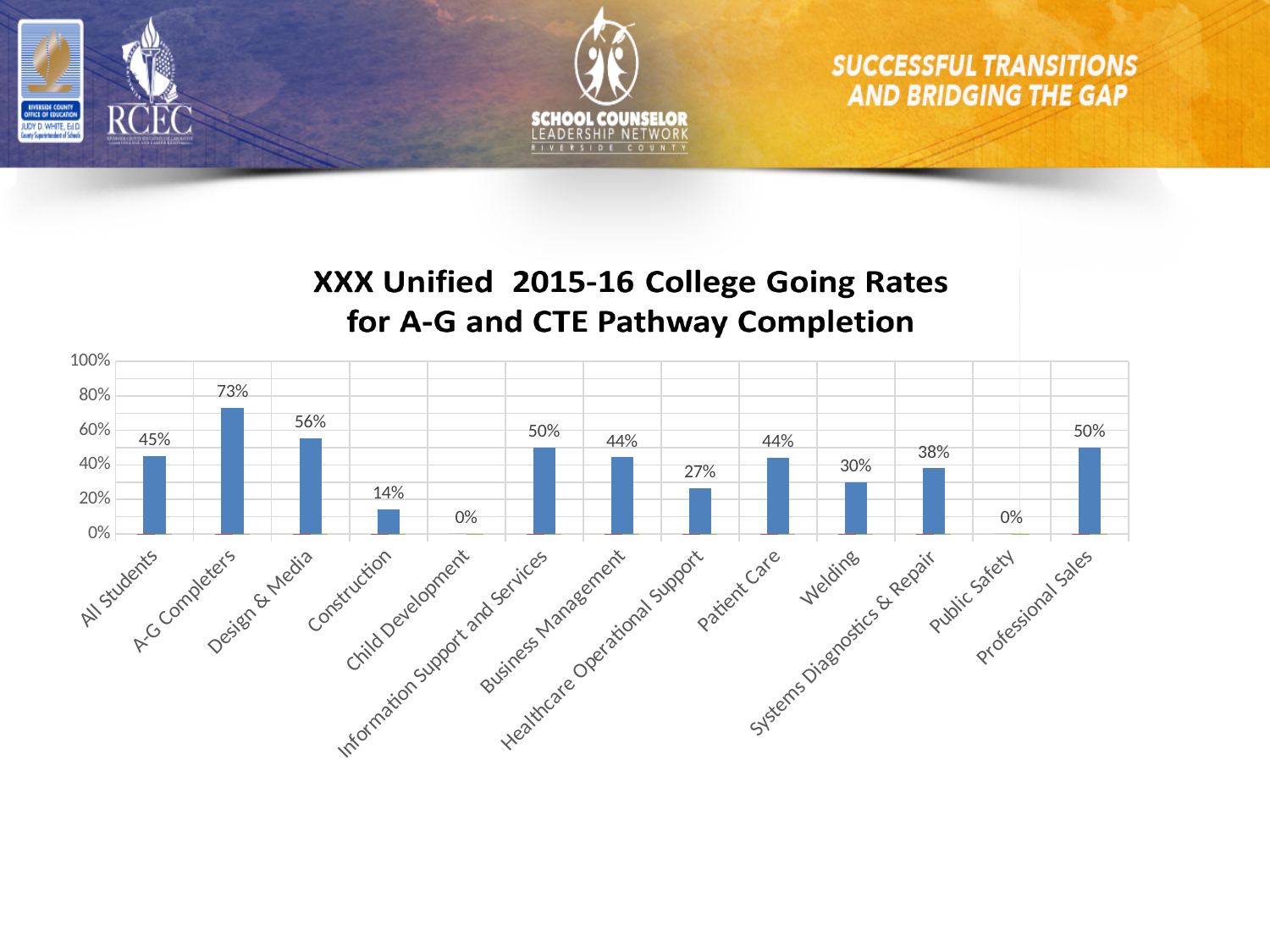
What is the title of the chart? XXX Unified 2015-16 College Going Rates for A-G and CTE Pathway Completion Which categories show a college going rate of 0%? Child Development and Public Safety What is the difference between the college going rate for A-G Completers and All Students? 28% What is the difference between the college going rates for Information Support and Services and Systems Diagnostics & Repair? 12% How many categories are shown on the x axis of the chart? 13 What is the college going rate for A-G Completers? 73% What is the college going rate for Welding? 30% Which category has the highest college going rate? A-G Completers Which has a higher college going rate, Design & Media or Professional Sales? Design & Media What kind of chart is shown on the slide? bar chart What is the college going rate for Healthcare Operational Support? 27% Is the college going rate for Construction greater or less than 20%? less